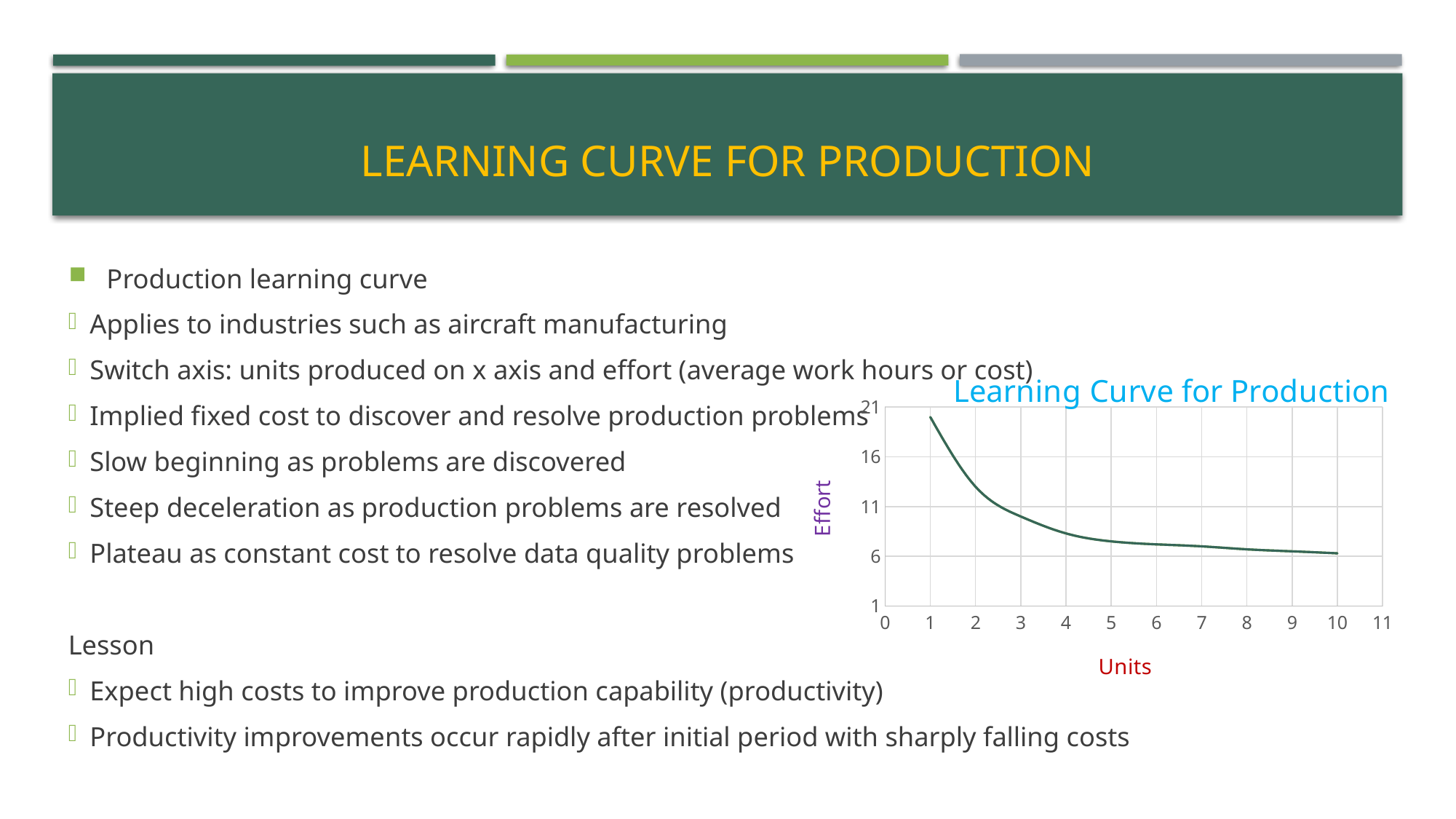
Is the effort at unit 2 greater or less than 11? greater Which has the larger effort value, unit 5 or unit 2? unit 2 Does the effort rise or fall as the number of units increases along the x axis? fall What is the label of the vertical axis of the chart? Effort Is the effort at unit 8 greater or less than 11? less What kind of chart is shown on the slide? line chart At which unit on the x axis is the effort lowest? 10 Is the effort at unit 4 greater or less than 11? less At which unit on the x axis is the effort highest? 1 What is the title of the chart on the slide? Learning Curve for Production Which has the larger effort value, unit 1 or unit 10? unit 1